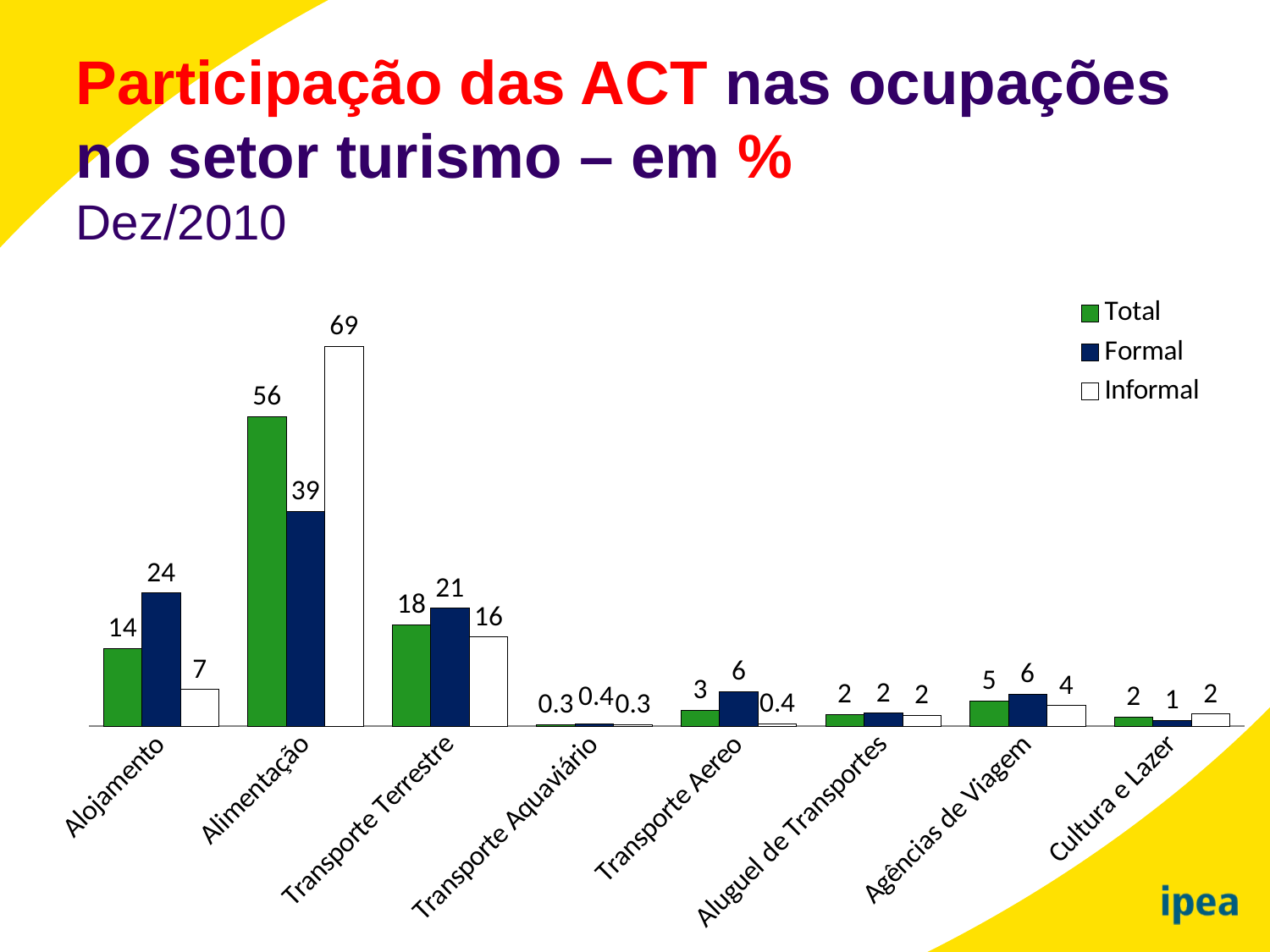
What is the difference between the Total and Formal values for Alimentação? 17 How many series does the legend list? 3 What is the Total value for Transporte Terrestre? 18 What is the Informal value for Transporte Aereo? 0.4 Which category has the lowest Formal value? Transporte Aquaviário What is the Informal value for Alimentação? 69 Which category has the highest Total value? Alimentação How many categories are shown on the x axis? 8 What is the Formal value for Alojamento? 24 What kind of chart is shown on the slide? Bar chart Which legend entry is shown in green? Total Which is larger for Alojamento: the Formal value or the Informal value? Formal